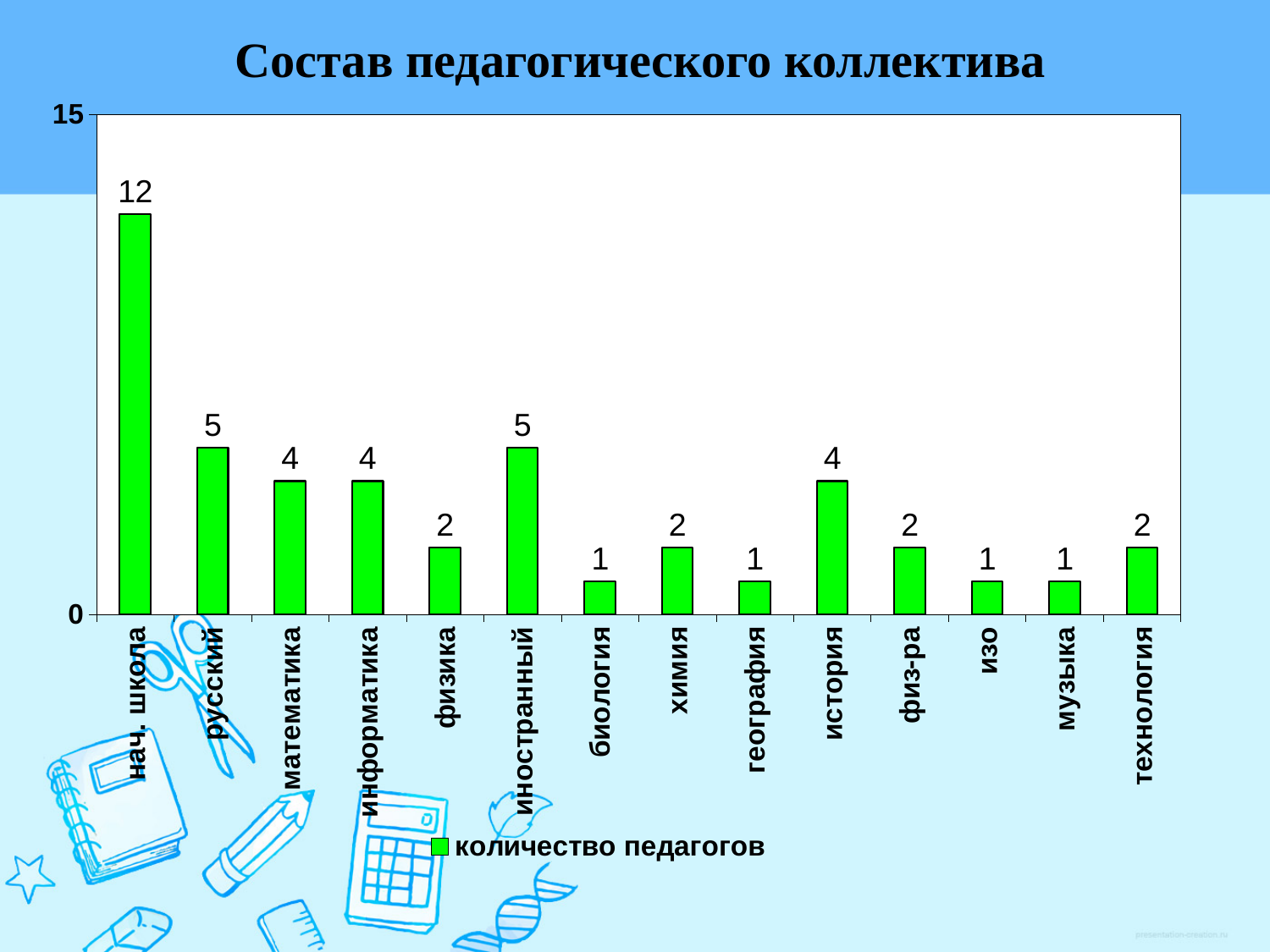
What is the difference between the values for нач. школа and русский? 7 What is the title of the chart? Состав педагогического коллектива What is the value for технология? 2 What kind of chart is shown? bar chart What is the value for нач. школа? 12 What is the value for история? 4 How many series does the legend list? 1 Which is larger, the value for математика or the value for физика? математика Which category has the highest value? нач. школа What is the value for иностранный? 5 How many categories are shown on the x axis? 14 Is the value for нач. школа greater or less than 15? less